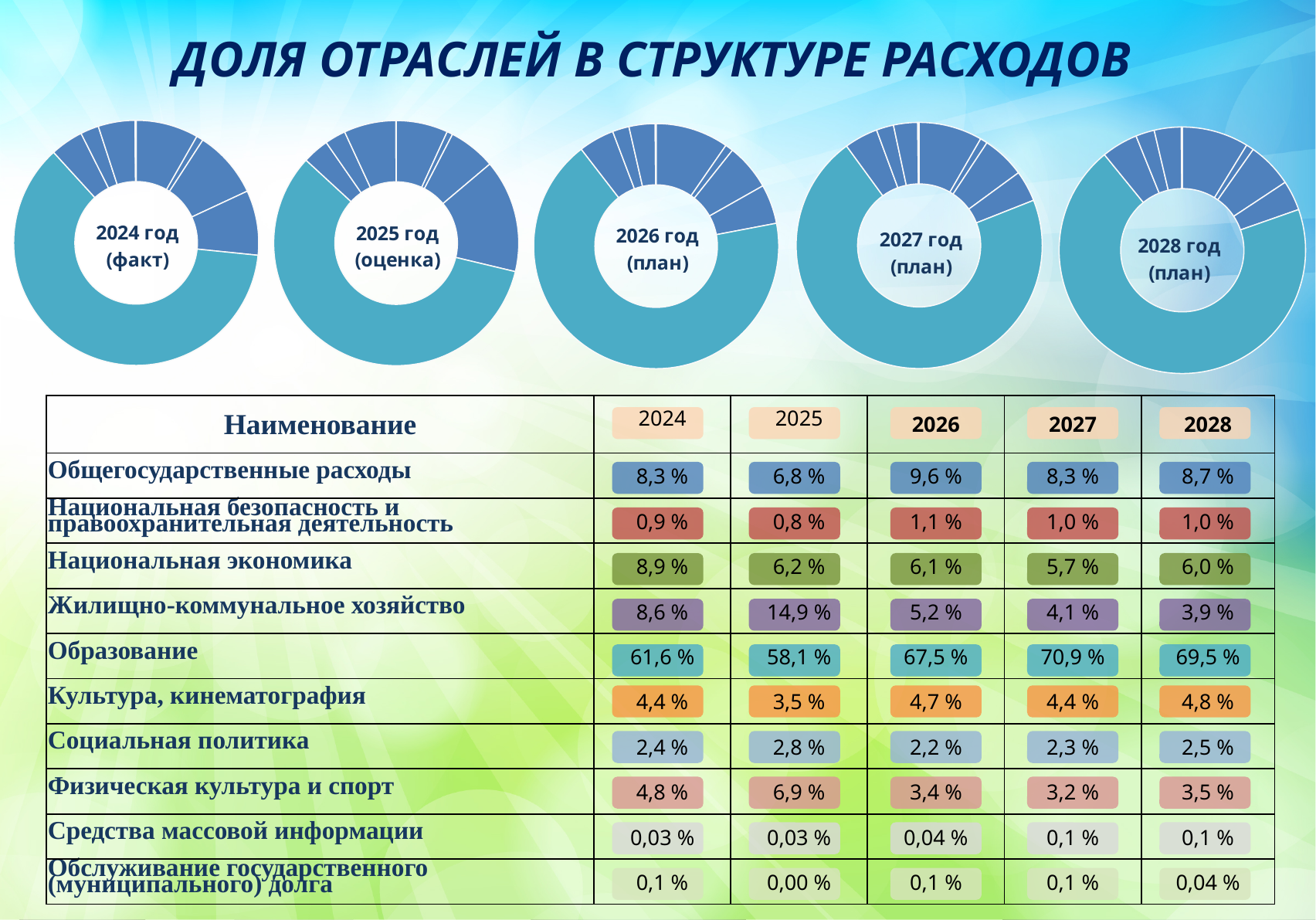
Does the share of Жилищно-коммунальное хозяйство rise or fall from 2025 to 2028? fall Which category has the largest share of expenditures in 2027? Образование By how many percentage points does the share of Образование in 2027 exceed its share in 2026? 3,4 % In 2026, which is larger: Общегосударственные расходы or Национальная экономика? Общегосударственные расходы Which category has the smallest share of expenditures in 2024? Средства массовой информации What is the title of the slide? ДОЛЯ ОТРАСЛЕЙ В СТРУКТУРЕ РАСХОДОВ How many expenditure categories are listed in the table? 10 How many doughnut charts are shown on the slide? 5 What kind of chart is used to show the 2024 год (факт) expenditure structure? doughnut (pie) chart What is the share of Образование in 2024? 61,6 % What is the share of Культура, кинематография in 2028? 4,8 % What is the share of Жилищно-коммунальное хозяйство in 2025? 14,9 %